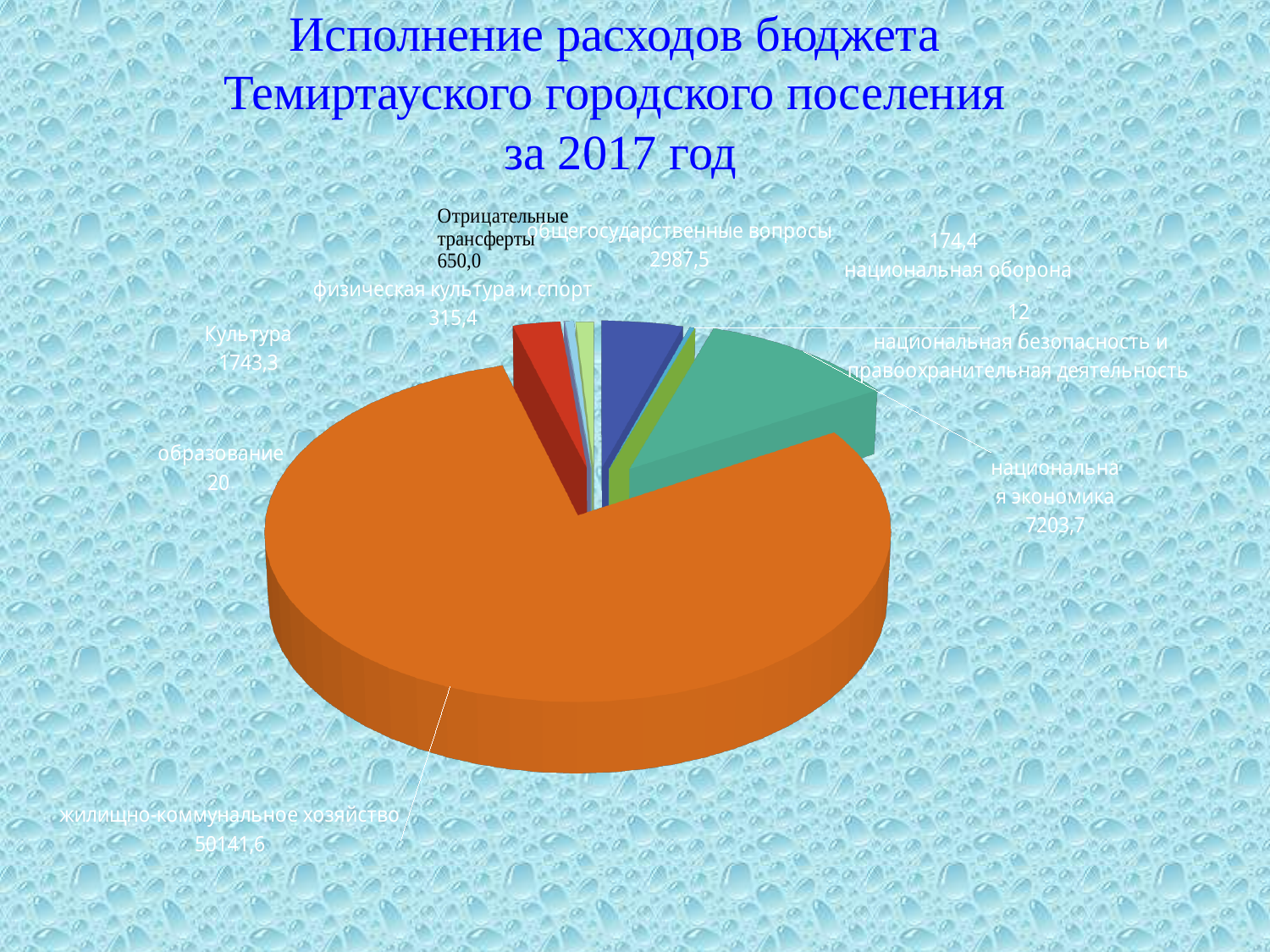
What year does the chart title refer to? 2017 How many categories are shown in the pie chart? 9 What type of chart is shown on the slide? pie chart Which category has the smallest value? национальная безопасность и правоохранительная деятельность What is the value for общегосударственные вопросы? 2987,5 What is the value for Отрицательные трансферты? 650,0 What is the difference between the values for национальная экономика and общегосударственные вопросы? 4216,2 What is the value for национальная экономика? 7203,7 What is the value for жилищно-коммунальное хозяйство? 50141,6 Which category has the largest value? жилищно-коммунальное хозяйство What is the value for Культура? 1743,3 Which is larger: the value for физическая культура и спорт or the value for Отрицательные трансферты? Отрицательные трансферты